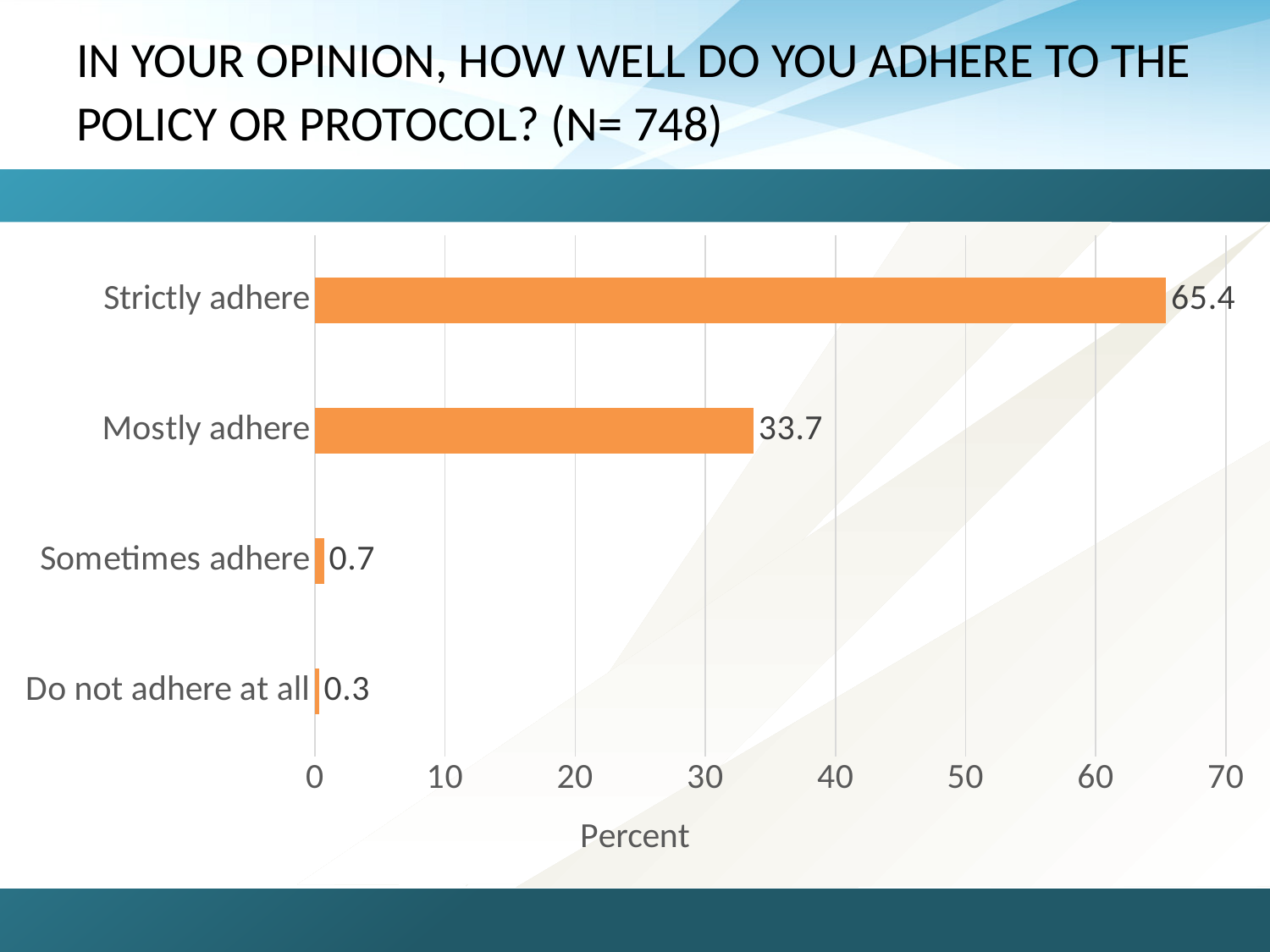
Which category has the highest value? Strictly adhere What is the value for Sometimes adhere? 0.7 What is the difference between the values for Strictly adhere and Mostly adhere? 31.7 What is the value for Strictly adhere? 65.4 How many categories are shown in the chart? 4 Which is larger, the value for Mostly adhere or the value for Sometimes adhere? Mostly adhere What is the value for Do not adhere at all? 0.3 Which category has the lowest value? Do not adhere at all What kind of chart is shown on the slide? Bar chart What is the value for Mostly adhere? 33.7 What is the label of the horizontal axis? Percent Is the value for Mostly adhere greater or less than 30? greater